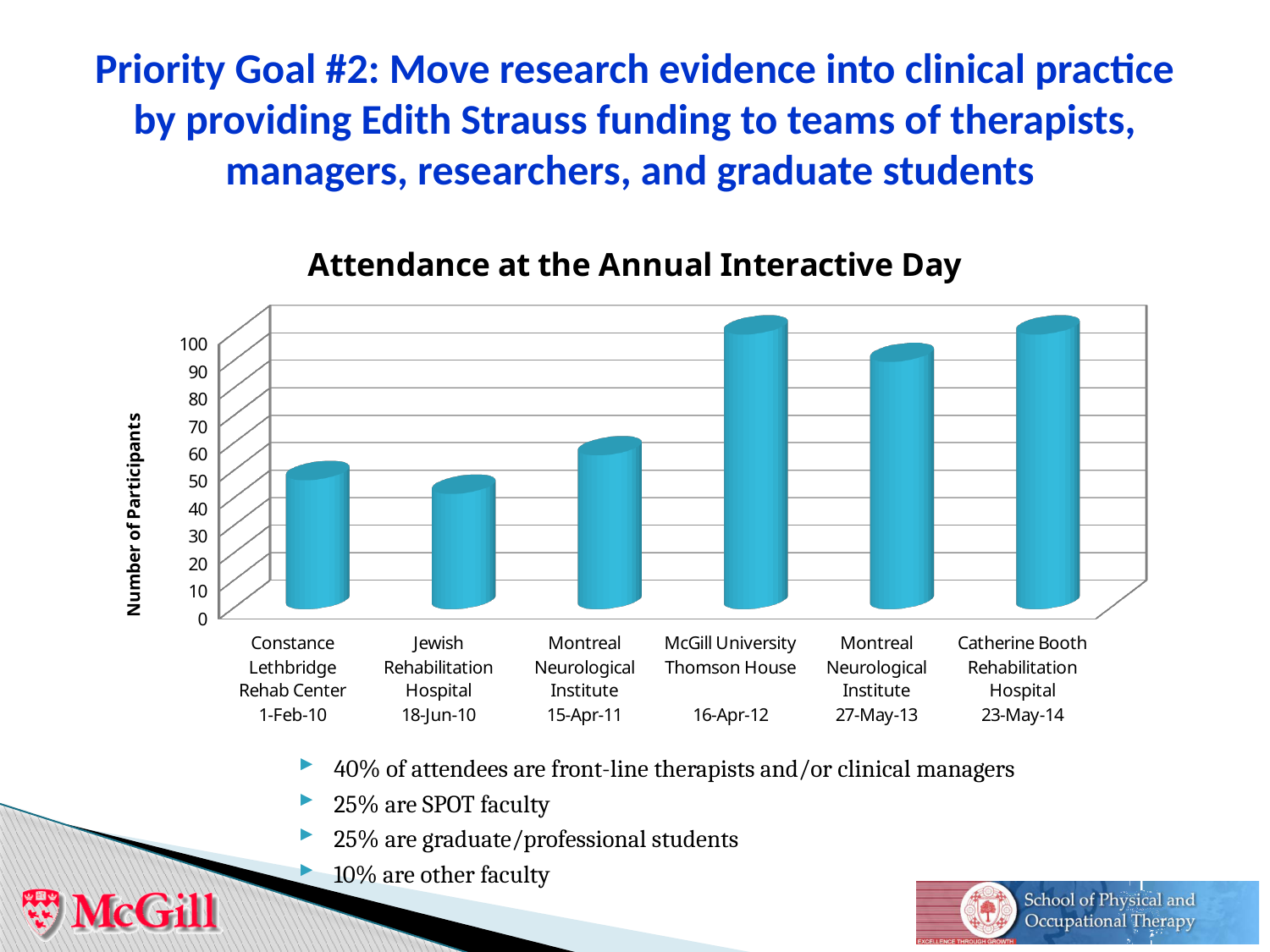
What is the label on the vertical axis of the chart? Number of Participants Is the attendance for Constance Lethbridge Rehab Center 1-Feb-10 greater or less than 60? less What kind of chart is shown on the slide? bar chart What is the title of the chart? Attendance at the Annual Interactive Day Is the attendance for Montreal Neurological Institute 27-May-13 greater or less than 80? greater Which event had the lowest attendance? Jewish Rehabilitation Hospital 18-Jun-10 Is the attendance for McGill University Thomson House 16-Apr-12 greater or less than 90? greater Which had higher attendance: McGill University Thomson House 16-Apr-12 or Constance Lethbridge Rehab Center 1-Feb-10? McGill University Thomson House 16-Apr-12 Which had higher attendance: Montreal Neurological Institute 15-Apr-11 or Jewish Rehabilitation Hospital 18-Jun-10? Montreal Neurological Institute 15-Apr-11 How many events (bars) are shown in the chart? 6 Overall, does attendance rise or fall from the first event (1-Feb-10) to the last event (23-May-14)? rise